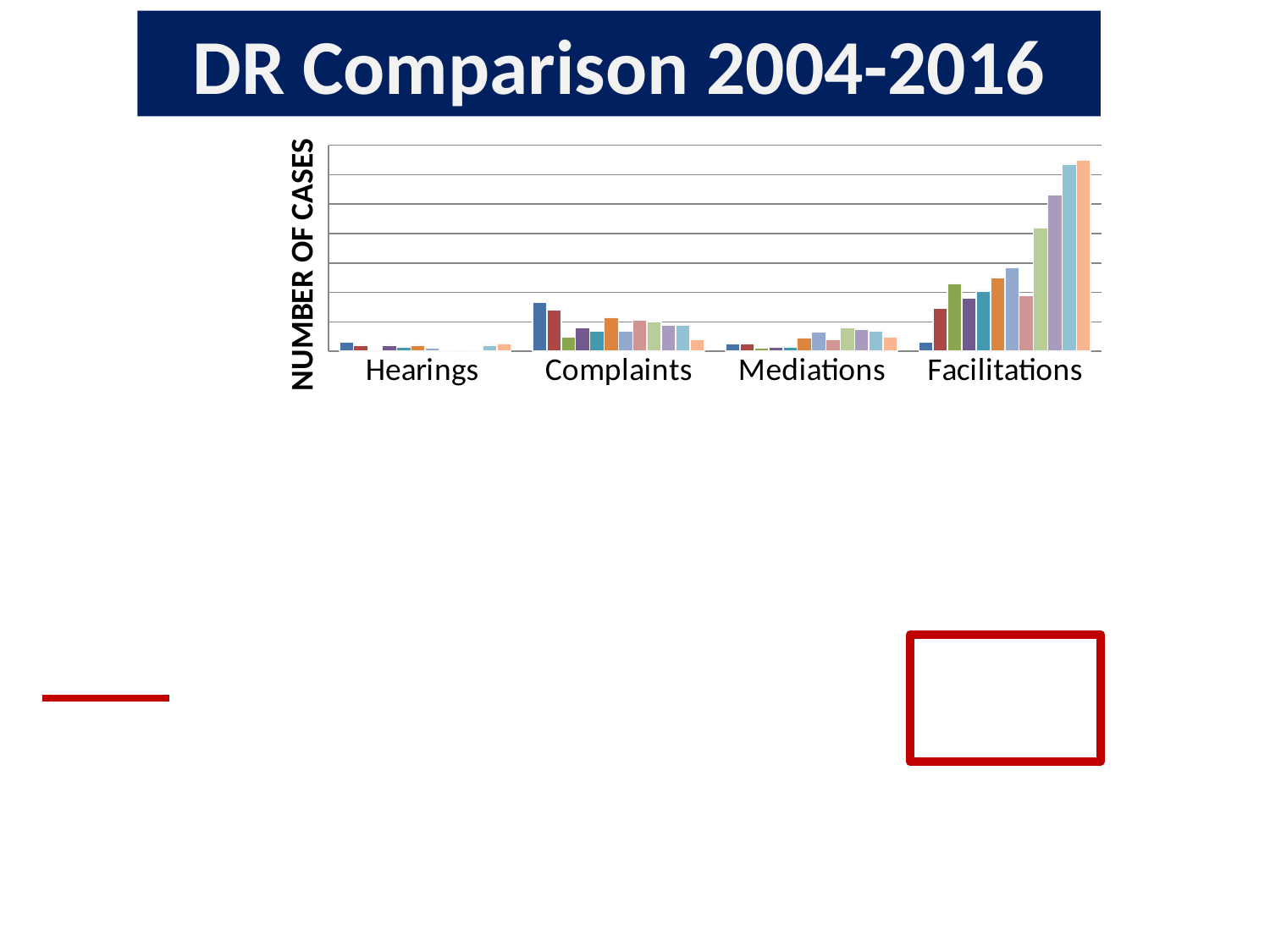
How many categories are shown on the x axis of the chart? 4 What is the label on the vertical axis of the chart? NUMBER OF CASES Which category reaches a higher number of cases, Facilitations or Hearings? Facilitations Which category reaches a higher number of cases, Mediations or Hearings? Mediations Which category has the lowest bars overall in the chart? Hearings What is the title of the chart on the slide? DR Comparison 2004-2016 Which category has the tallest bar in the chart? Facilitations What kind of chart is shown on the slide? bar chart Which category reaches a higher number of cases, Complaints or Mediations? Complaints